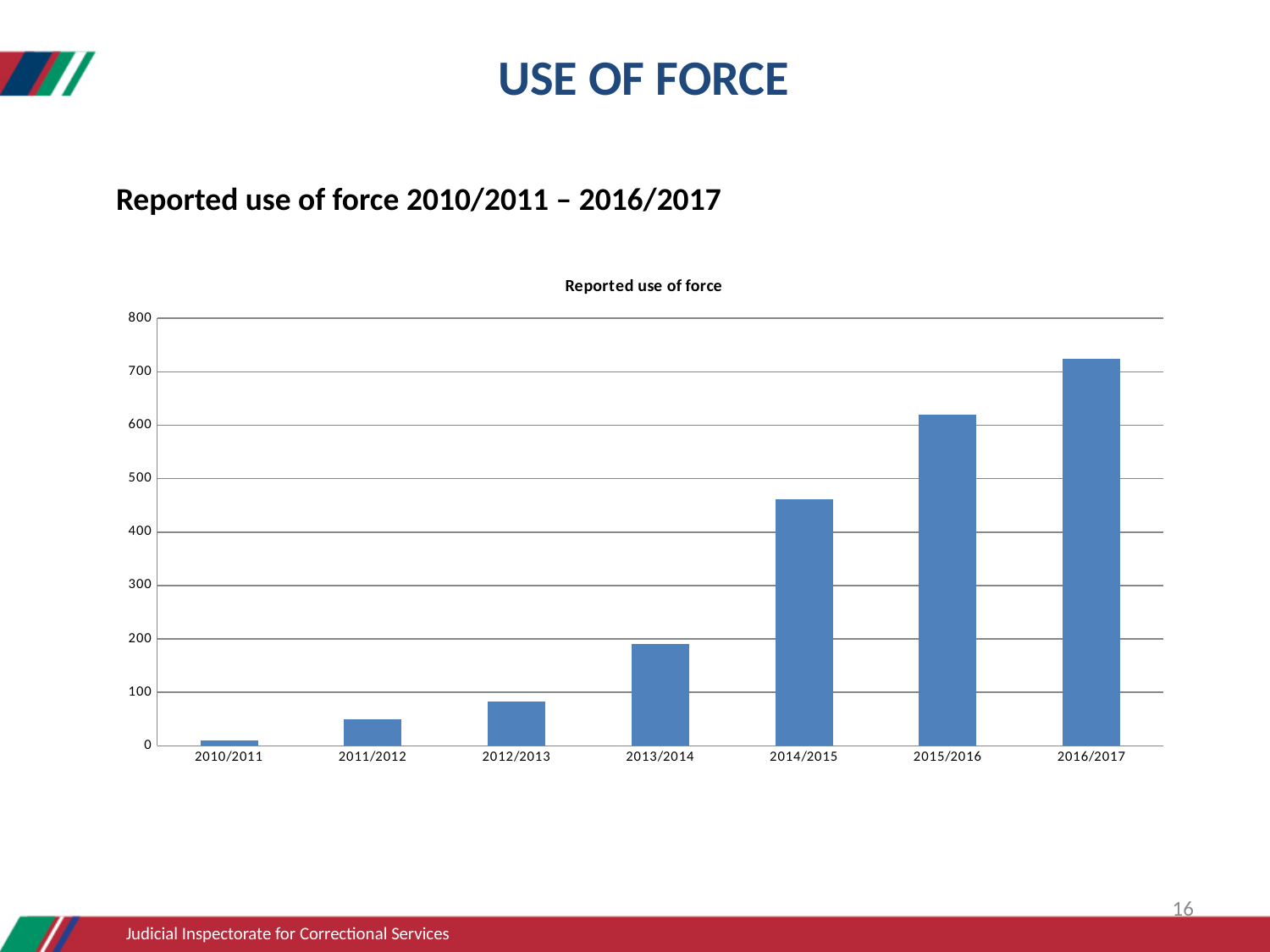
What is the title of the chart? Reported use of force Is the value for 2012/2013 greater or less than 100? less Which year has the highest reported use of force? 2016/2017 What type of chart is shown on the slide? bar chart Which is larger, the value for 2014/2015 or the value for 2013/2014? 2014/2015 Is the value for 2014/2015 greater or less than 500? less Is the value for 2015/2016 greater or less than 600? greater Do the values rise or fall from 2010/2011 to 2016/2017? rise How many years (categories) are shown on the x axis of the chart? 7 Which year has the lowest reported use of force? 2010/2011